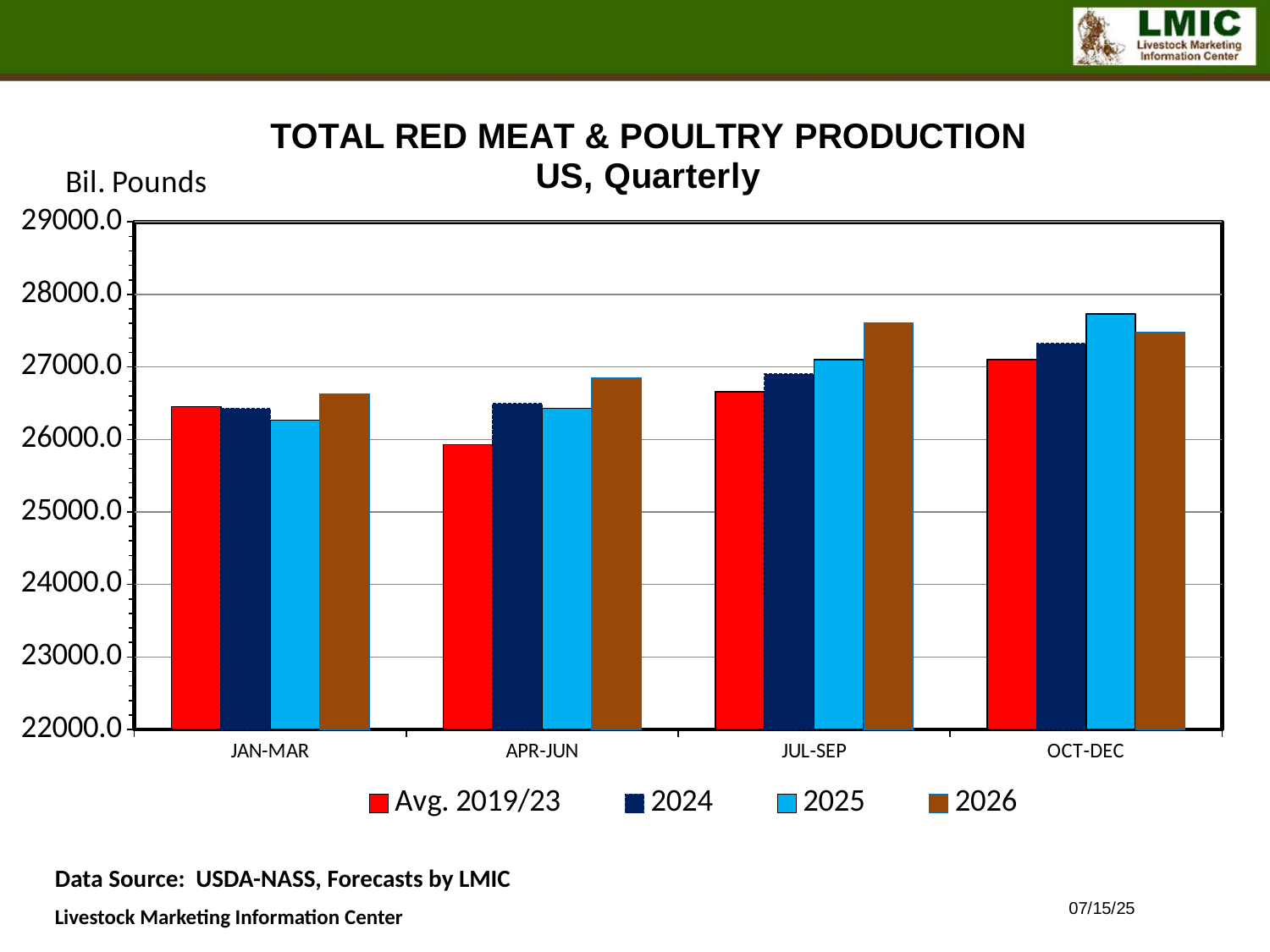
Which series has the highest value in JUL-SEP? 2026 Is the Avg. 2019/23 value for APR-JUN greater or less than 26000.0? less In JUL-SEP, which is larger: the 2025 value or the 2026 value? 2026 What unit label is shown above the y axis? Bil. Pounds How many series does the legend list? 4 In OCT-DEC, which is larger: the 2025 value or the 2026 value? 2025 How many quarters are shown on the x axis? 4 Is the 2025 value for JAN-MAR greater or less than 26000.0? greater Which quarter has the lowest Avg. 2019/23 value? APR-JUN Is the 2026 value for JUL-SEP greater or less than 27000.0? greater Do the 2025 values rise or fall from JAN-MAR to OCT-DEC? rise What kind of chart is shown on the slide? bar chart